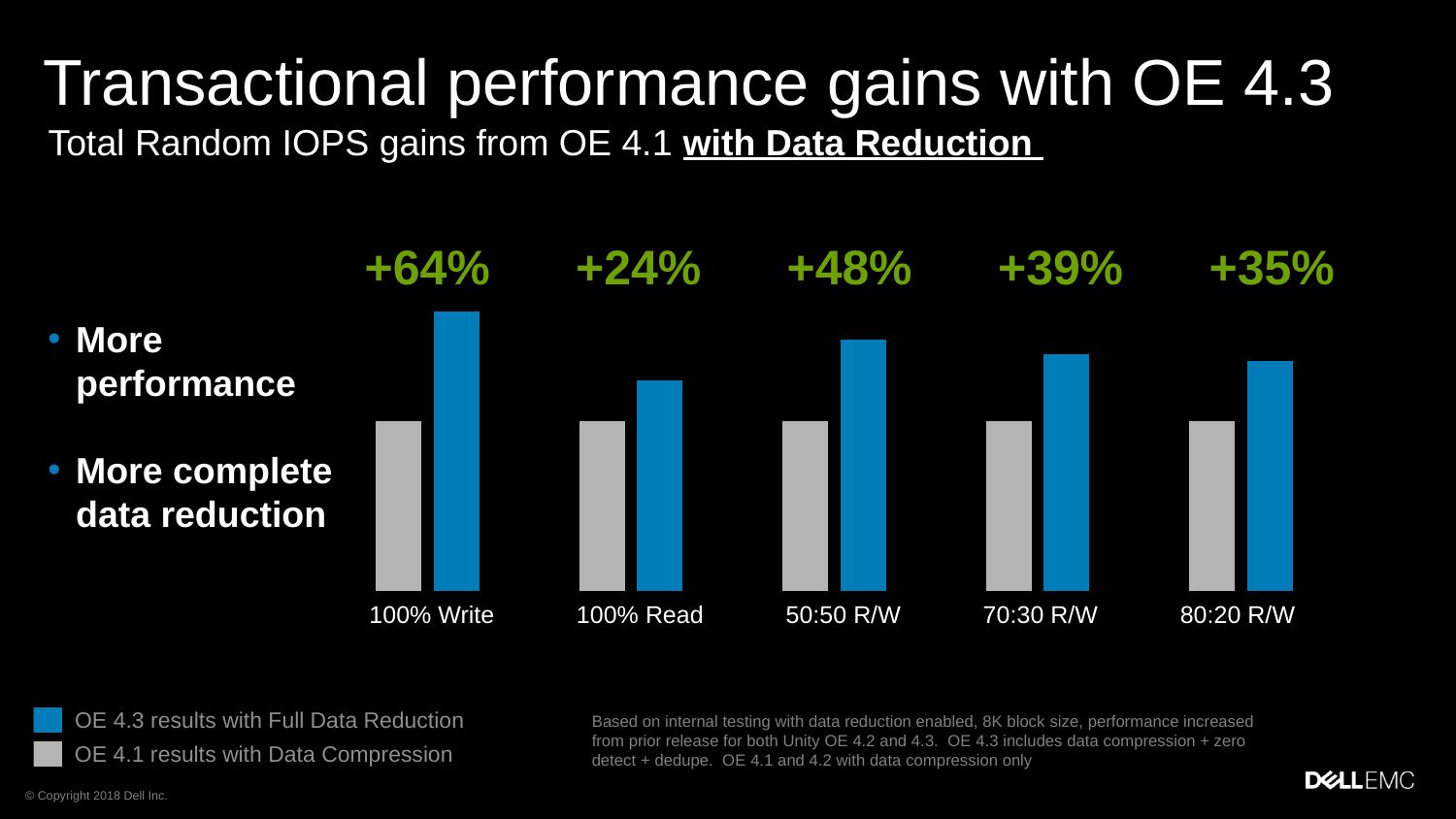
What percentage gain is shown above the 100% Write category? +64% Which series is shown in blue according to the legend? OE 4.3 results with Full Data Reduction How many series does the legend list? 2 What is the subtitle of the chart below the main title? Total Random IOPS gains from OE 4.1 with Data Reduction What kind of chart is shown on the slide? Bar chart How many workload categories are shown on the x axis? 5 What is the difference in percentage points between the gain for 100% Write and the gain for 100% Read? 40 percentage points For the 70:30 R/W category, which bar is taller: OE 4.3 results with Full Data Reduction or OE 4.1 results with Data Compression? OE 4.3 results with Full Data Reduction What percentage gain is shown above the 80:20 R/W category? +35% Which workload category shows the smallest percentage gain? 100% Read What percentage gain is shown above the 50:50 R/W category? +48% Which workload category shows the largest percentage gain? 100% Write